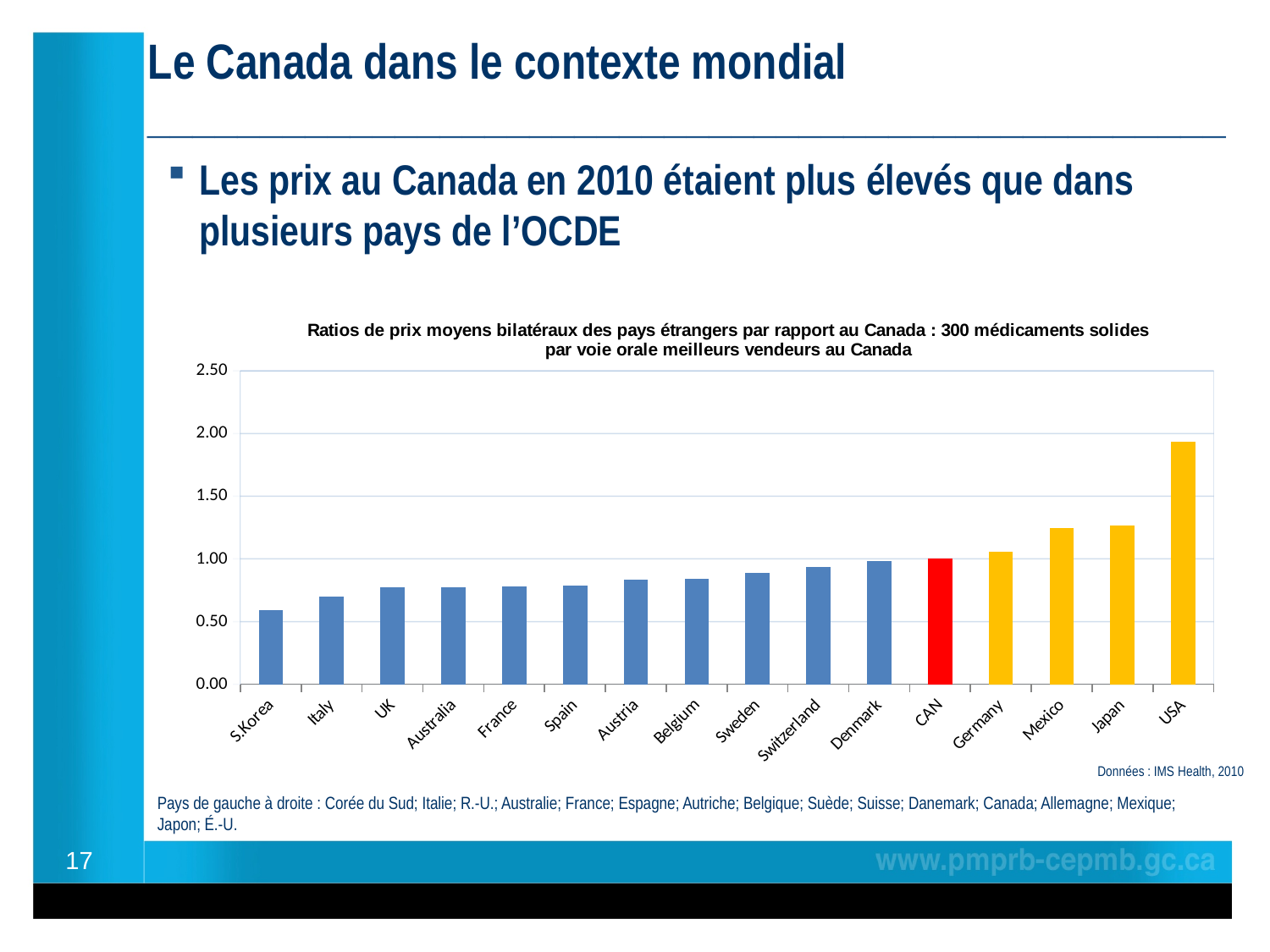
What kind of chart is shown on the slide? bar chart What colour is the bar for CAN? red Do the values rise or fall from left to right along the x axis? rise Is the value for Germany greater or less than 1.00? greater Which country has the highest price ratio on the chart? USA Which is larger, the value for Italy or the value for Denmark? Denmark What is the value for CAN on the chart? 1.00 Is the value for Japan greater or less than 1.50? less Is the value for USA greater or less than 1.50? greater How many countries are plotted on the chart? 16 Which country has the lowest price ratio on the chart? S.Korea